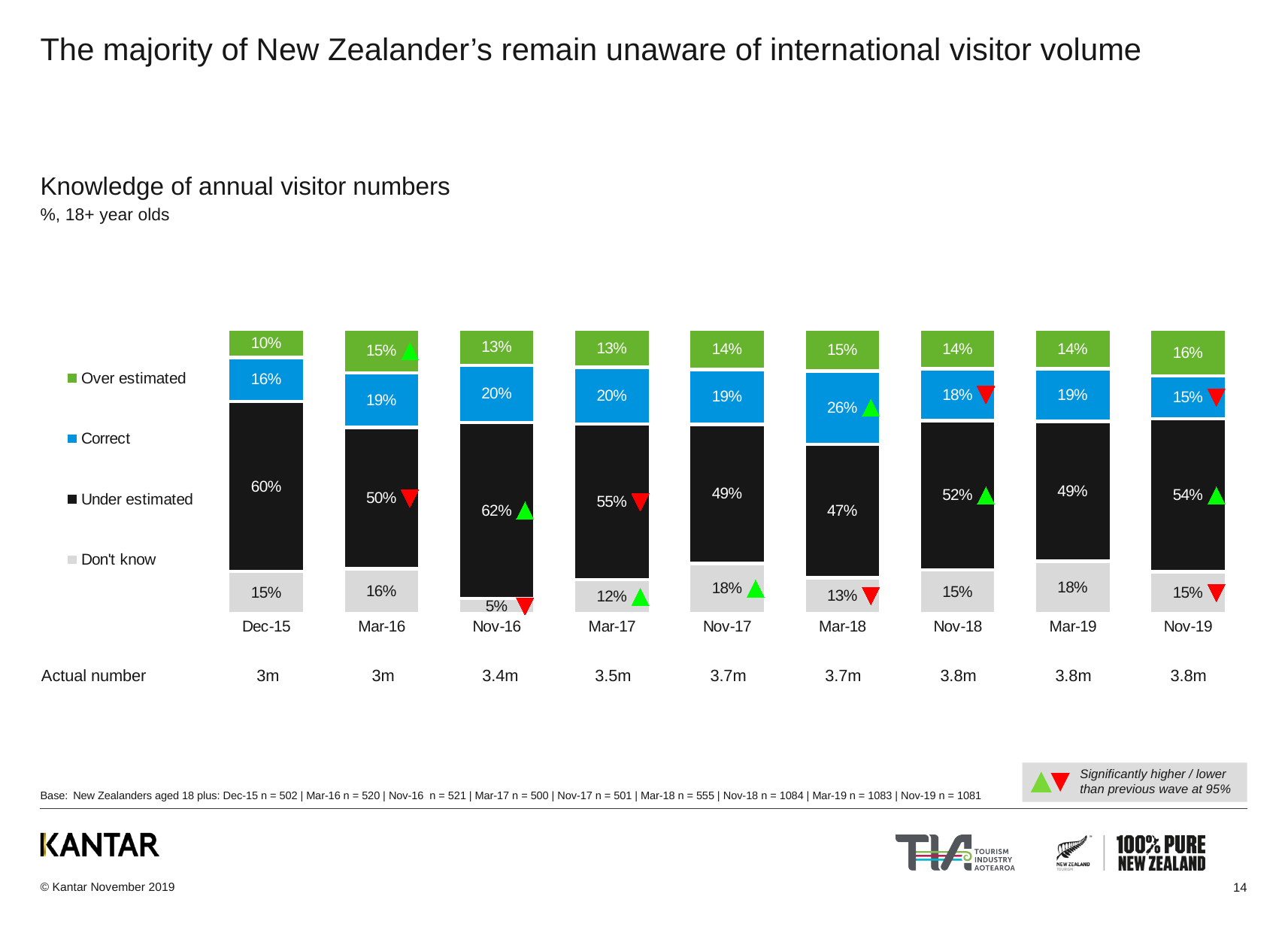
In which wave is the Under estimated share highest? Nov-16 What is the total of the stacked bar for Mar-16? 100% How many series does the legend list? 4 What is the Actual number shown for Nov-19? 3.8m What is the Correct value for Mar-18? 26% What percentage of respondents under estimated visitor numbers in Nov-16? 62% In which wave is the Don't know share lowest? Nov-16 What is the Don't know value for Nov-17? 18% What is the difference in percentage points between the Correct value in Mar-18 and the Correct value in Nov-19? 11 percentage points What kind of chart is shown on the slide? Stacked bar chart How many waves (time periods) are shown on the x axis? 9 Which is larger: the Over estimated value in Dec-15 or the Over estimated value in Nov-19? Nov-19